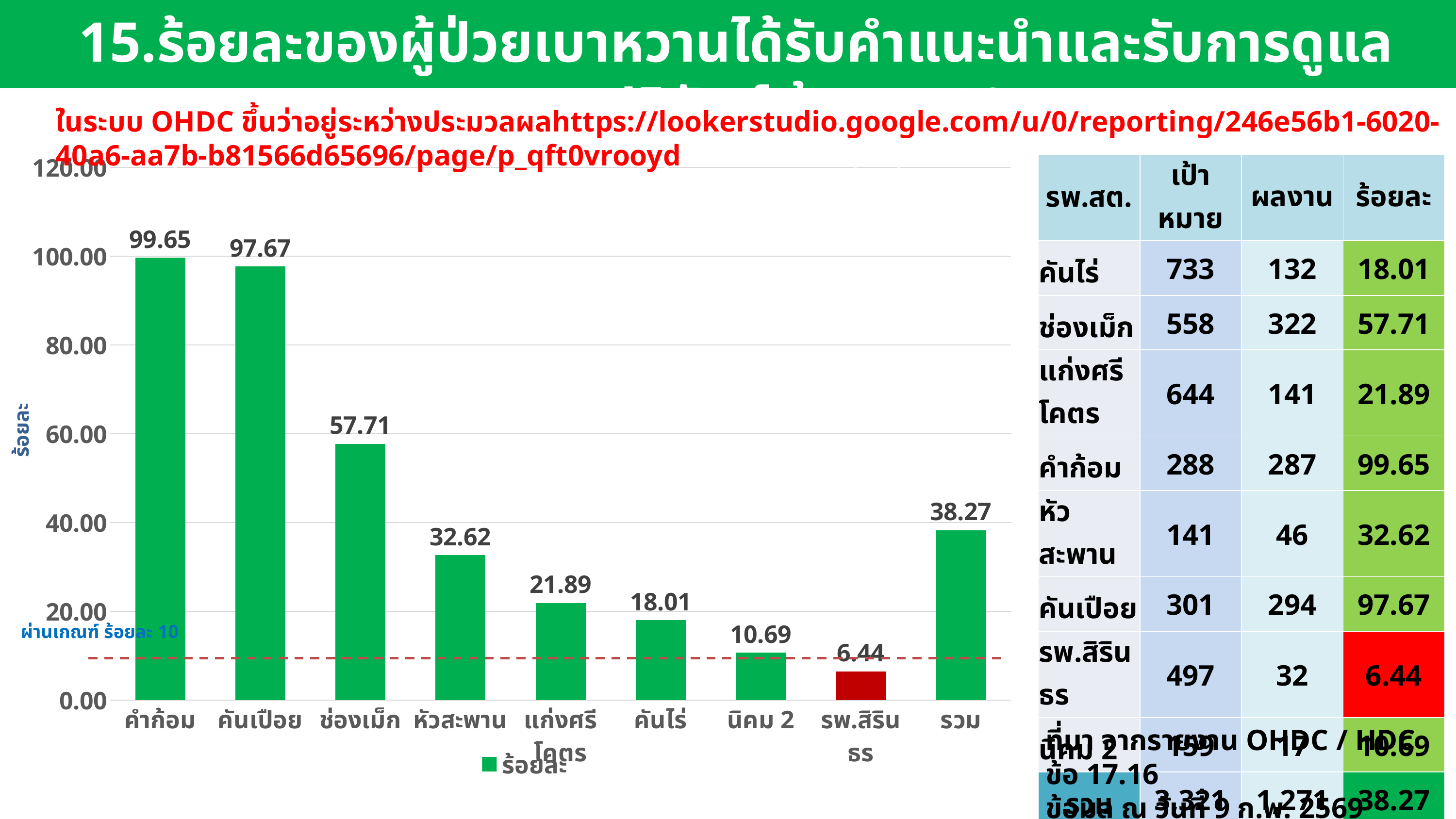
What is the value for คำก้อม in the bar chart? 99.65 What is the difference between the values for คำก้อม and คันเปือย? 1.98 Which category has the lowest value in the bar chart? รพ.สิรินธร What is the value for รวม in the bar chart? 38.27 How many series does the legend of the bar chart list? 1 Which bar in the chart is coloured red instead of green? รพ.สิรินธร Which category has the highest value in the bar chart? คำก้อม Which is larger, the value for ช่องเม็ก or the value for หัวสะพาน? ช่องเม็ก Is the value for นิคม 2 greater or less than 20? less What type of chart is shown on the slide? bar chart What is the value for รพ.สิรินธร in the bar chart? 6.44 How many categories are shown on the x axis of the bar chart? 9